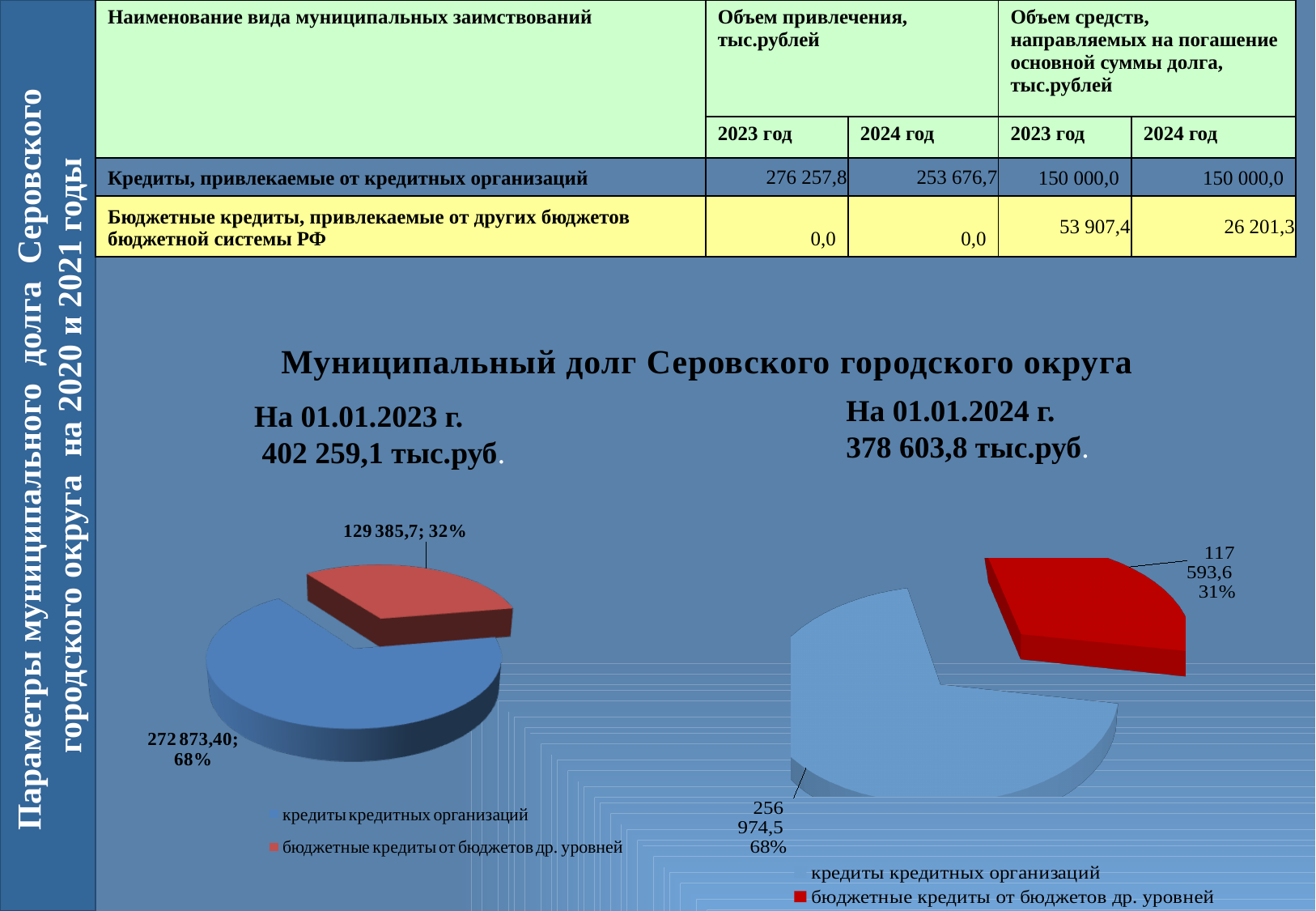
In the pie chart for 01.01.2023, what is the value for кредиты кредитных организаций? 272 873,40 In the pie chart for 01.01.2023, what share of the pie is бюджетные кредиты от бюджетов др. уровней? 32% What is the common title above the two pie charts? Муниципальный долг Серовского городского округа How many slices does the pie chart for 01.01.2023 have? 2 In the pie chart for 01.01.2024, which is larger: кредиты кредитных организаций or бюджетные кредиты от бюджетов др. уровней? кредиты кредитных организаций In the pie chart for 01.01.2024, which category is the largest? кредиты кредитных организаций In the pie chart for 01.01.2024, what is the value for бюджетные кредиты от бюджетов др. уровней? 117 593,6 In the pie chart for 01.01.2024, what share of the pie is кредиты кредитных организаций? 68% What kind of chart is used for the municipal debt as of 01.01.2023? pie chart In the pie chart for 01.01.2023, which category is the smallest? бюджетные кредиты от бюджетов др. уровней In the pie chart for 01.01.2023, what is the value for бюджетные кредиты от бюджетов др. уровней? 129 385,7 In the pie chart for 01.01.2024, what is the value for кредиты кредитных организаций? 256 974,5